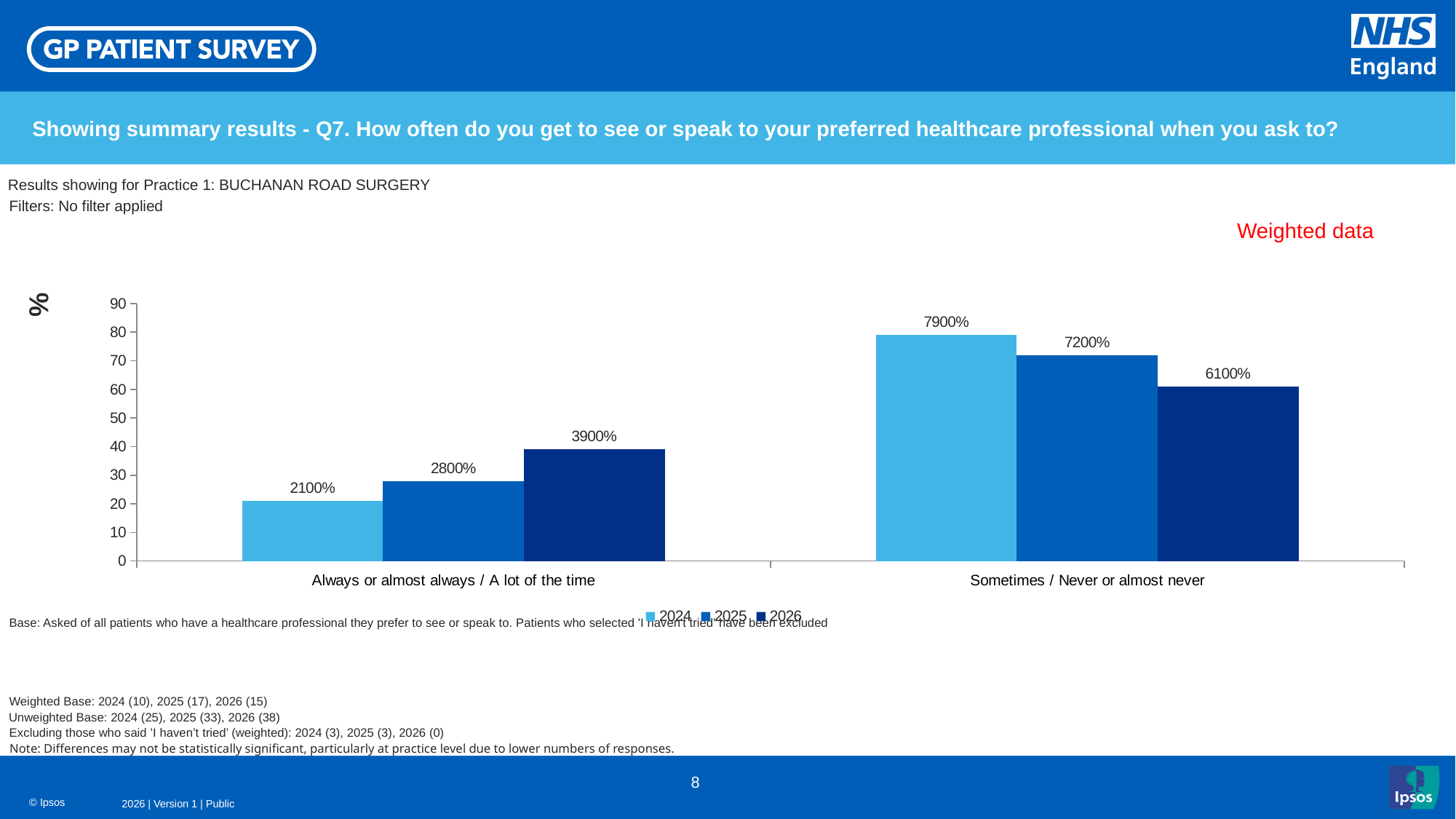
What is the data label for 2024 in the 'Always or almost always / A lot of the time' category? 2100% What is the data label for 2026 in the 'Sometimes / Never or almost never' category? 6100% How many series does the legend list? 3 Which year has the lowest bar in the 'Always or almost always / A lot of the time' category? 2024 What kind of chart is shown on the slide? bar chart Do the bars for 'Always or almost always / A lot of the time' rise or fall from 2024 to 2026? rise Do the bars for 'Sometimes / Never or almost never' rise or fall from 2024 to 2026? fall How many categories are shown on the x axis? 2 What are the three entries listed in the chart legend? 2024, 2025, 2026 Is the 2025 bar for 'Sometimes / Never or almost never' larger or smaller than the 2026 bar in the same category? larger Which year has the highest bar in the 'Sometimes / Never or almost never' category? 2024 What is the data label for 2025 in the 'Always or almost always / A lot of the time' category? 2800%